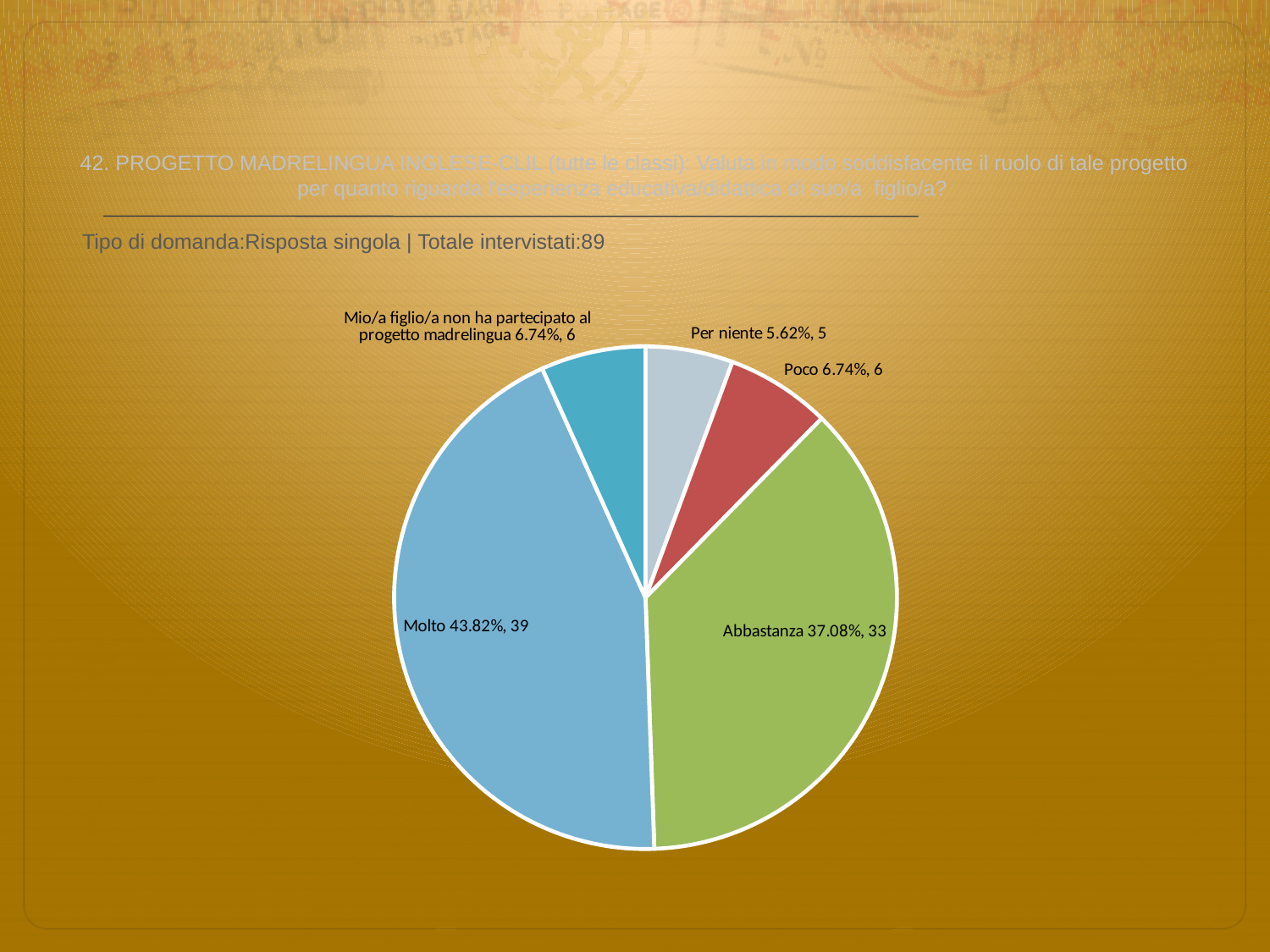
Which category has the largest slice of the pie? Molto What percentage share does the "Molto" slice have? 43.82% Which category has the smallest slice of the pie? Per niente How many respondents answered "Poco"? 6 What is the difference in respondent count between "Molto" and "Abbastanza"? 6 What kind of chart is shown on the slide? pie chart How many slices does the pie chart have? 5 How many respondents answered "Abbastanza"? 33 What percentage share does the "Per niente" slice have? 5.62% How many respondents answered "Mio/a figlio/a non ha partecipato al progetto madrelingua"? 6 What is the total number of respondents (Totale intervistati) stated on the slide? 89 Which has more respondents, "Abbastanza" or "Poco"? Abbastanza